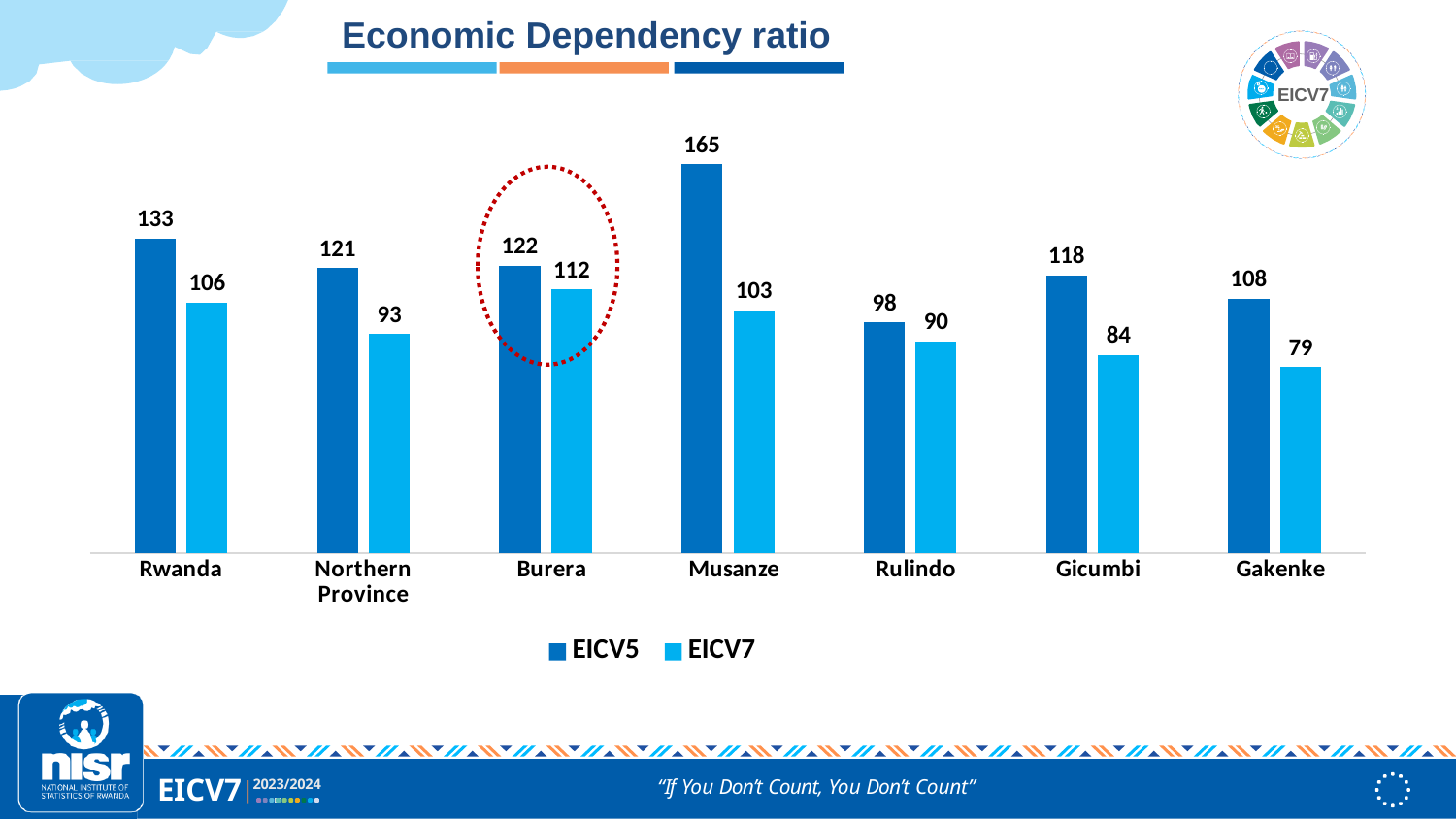
What is the difference between the EICV5 and EICV7 values for Burera? 10 Which is larger, the EICV7 value for Rulindo or the EICV7 value for Gicumbi? Rulindo Which category has the lowest EICV7 value? Gakenke Which category has the highest EICV5 value? Musanze What is the EICV5 economic dependency ratio for Musanze? 165 How many categories are shown on the x axis? 7 Which category is highlighted with a red dotted circle? Burera What is the EICV7 value for Gakenke? 79 What is the EICV7 economic dependency ratio for Rwanda? 106 What kind of chart is shown on the slide? Bar chart What is the difference between the EICV5 and EICV7 values for Musanze? 62 How many series does the legend list? 2